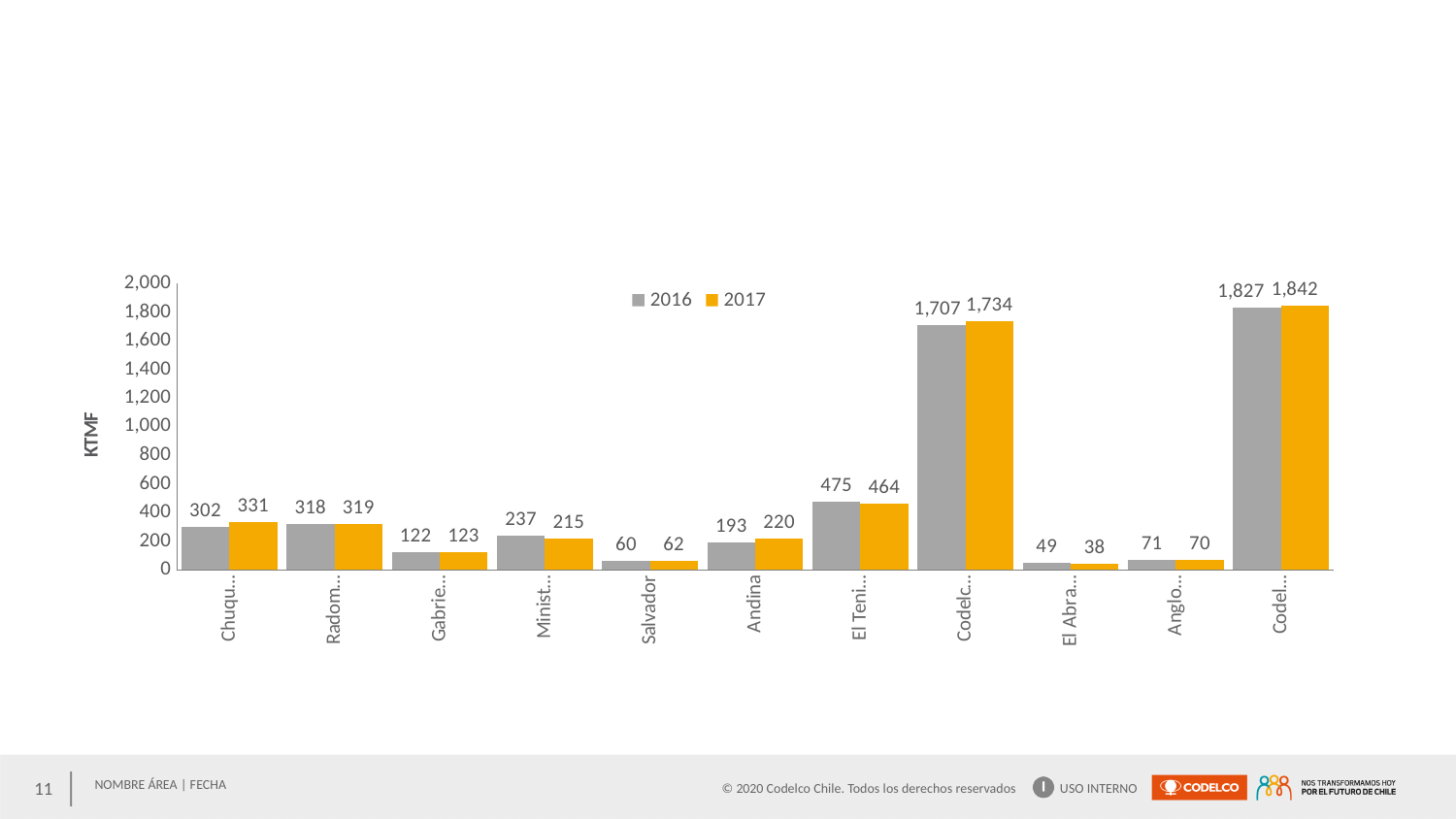
What is the 2017 value for Salvador? 62 What is the 2016 value for Andina? 193 What is the 2016 value for Salvador? 60 What is the 2017 value for Andina? 220 How many series does the legend list? 2 What kind of chart is this? bar chart Which has the larger 2016 value, Andina or Salvador? Andina By how much did Andina's value increase from 2016 to 2017? 27 What is the label on the vertical axis? KTMF How many categories are shown on the x axis? 11 What is the highest 2017 value shown on the chart? 1,842 What is the lowest 2016 value shown on the chart? 49